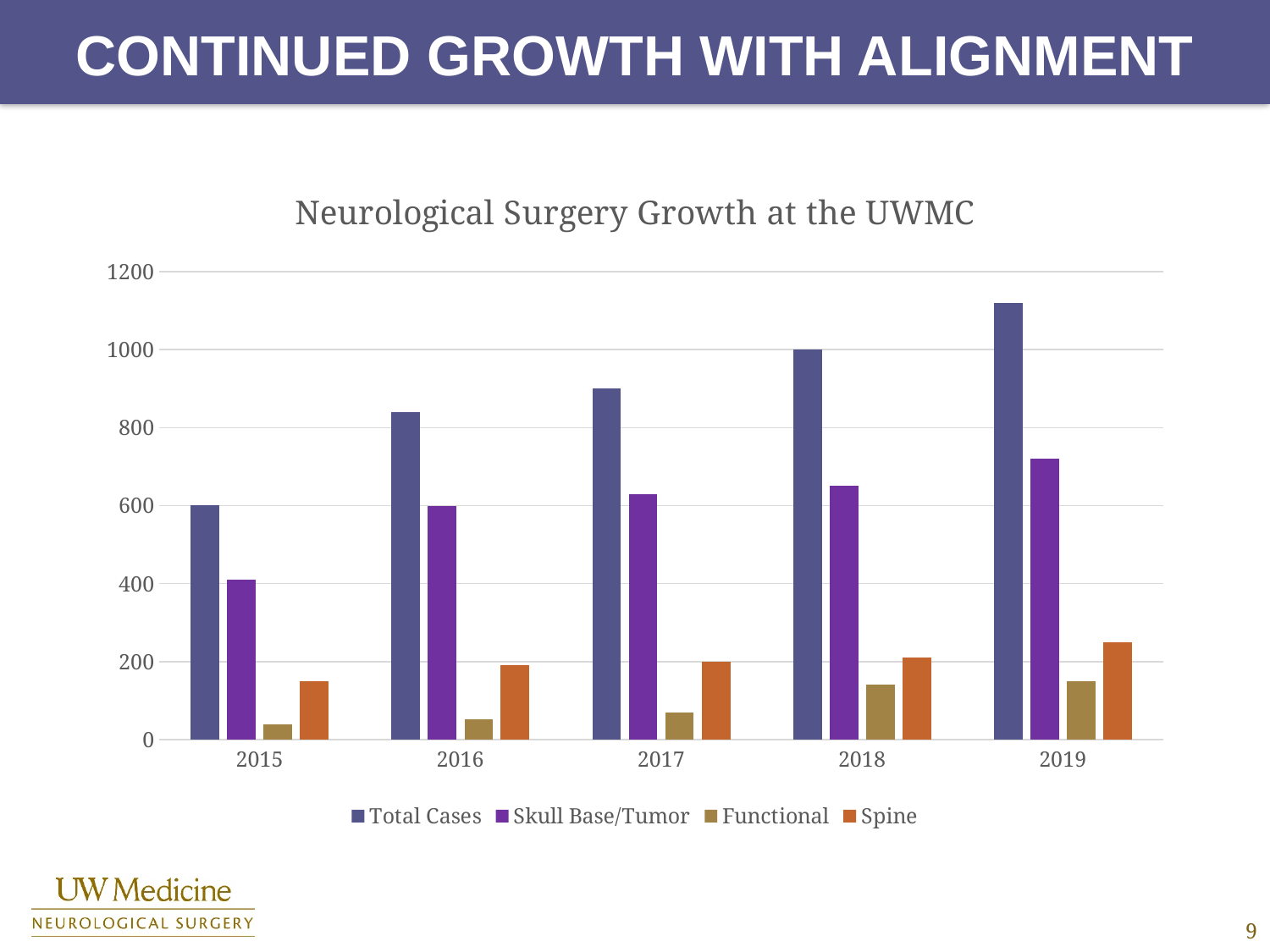
Which year has the lowest value for Functional? 2015 What is the title of the chart? Neurological Surgery Growth at the UWMC What is the value for Total Cases in 2018? 1000 Which year has the highest value for Total Cases? 2019 Which is larger in 2018, the value for Functional or the value for Spine? Spine Is the value for Total Cases in 2019 greater or less than 1000? greater What kind of chart is shown on the slide? bar chart Do the Total Cases values rise or fall from 2015 to 2019? rise How many years are shown on the x axis? 5 How many series does the legend list? 4 Is the value for Skull Base/Tumor in 2015 greater or less than 600? less Is the value for Spine in 2019 greater or less than 200? greater